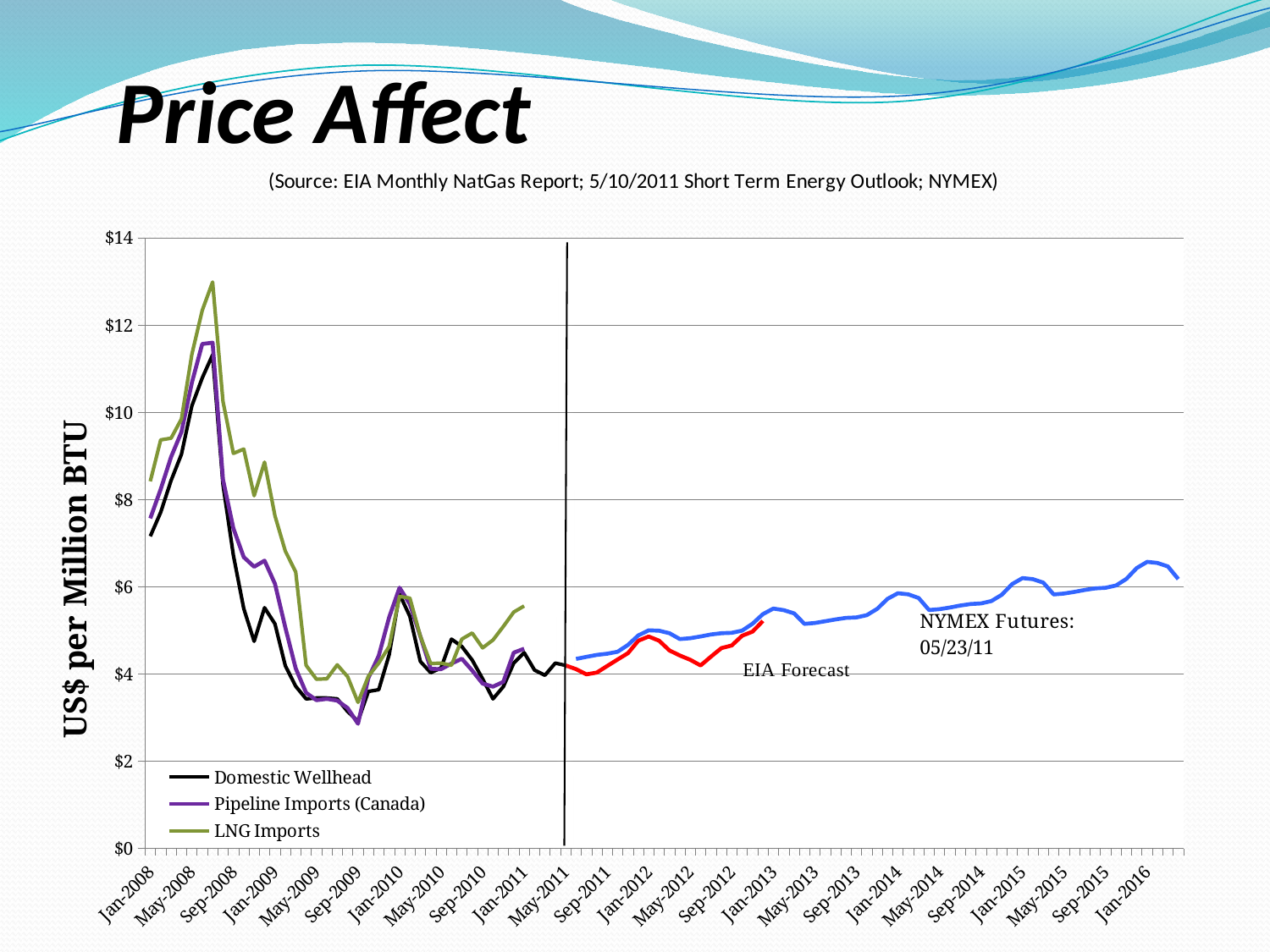
Do the Domestic Wellhead values rise or fall between Sep-2008 and May-2009? fall Is the lowest value of Pipeline Imports (Canada) greater or less than $4? less Is the peak value of LNG Imports greater or less than $12? greater In Jan-2008, which is higher: LNG Imports or Domestic Wellhead? LNG Imports What is the label on the vertical axis of the chart? US$ per Million BTU Is the peak value of Domestic Wellhead in 2008 greater or less than $10? greater Which series reaches the highest peak value on the chart? LNG Imports What kind of chart is shown on the slide? line chart How many series does the chart legend list? 3 Which series is listed second in the chart legend? Pipeline Imports (Canada)